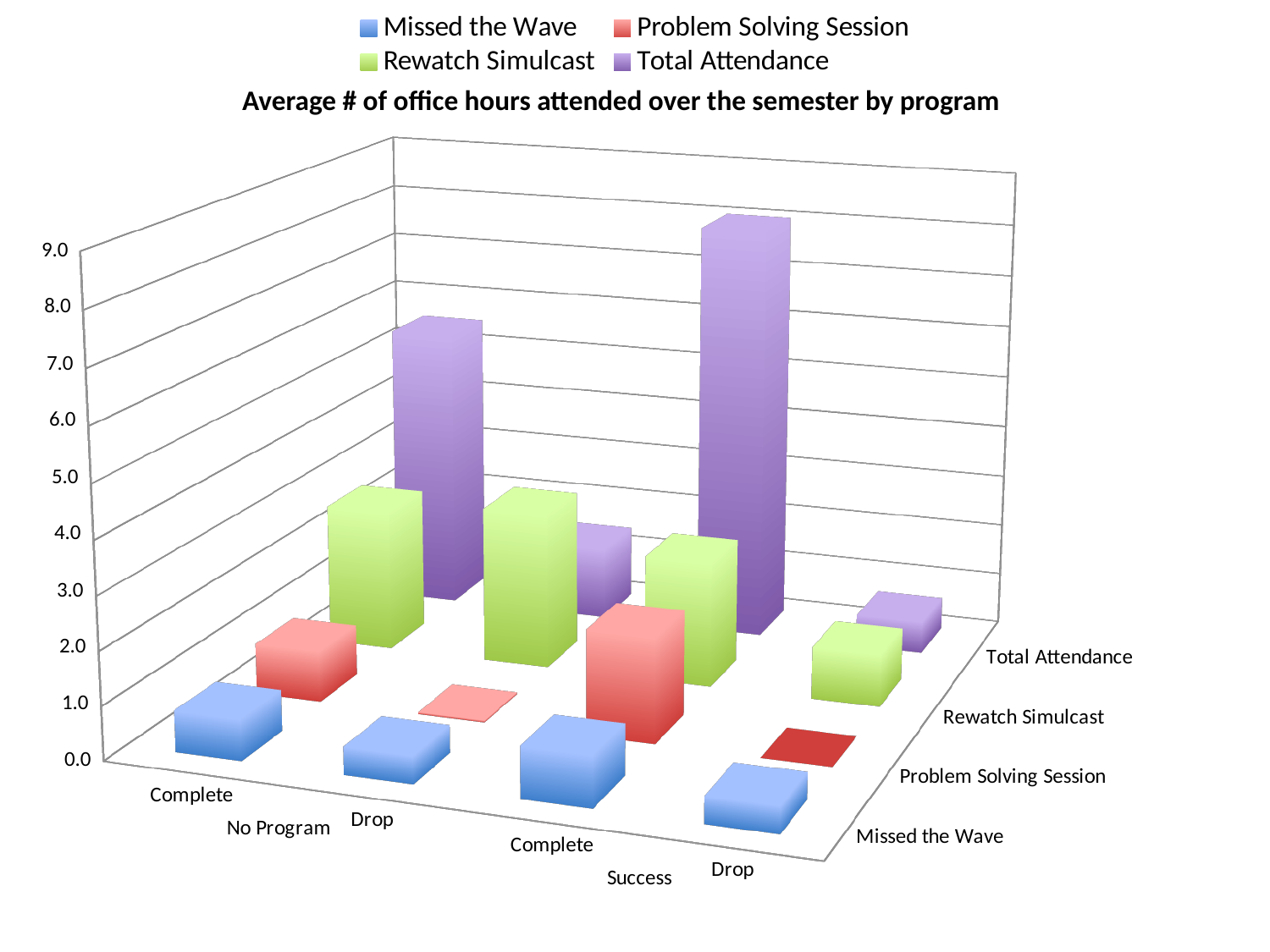
Is the Total Attendance value for Complete under No Program greater or less than 4.0? greater For the Total Attendance series, which category has the lowest value? Drop (Success) Which is larger for Problem Solving Session: Complete under Success or Drop under Success? Complete under Success Which is larger for Total Attendance: Complete under No Program or Complete under Success? Complete under Success Is the Total Attendance value for Complete under Success greater or less than 6.0? greater What kind of chart is shown on the slide? bar chart Is the Problem Solving Session value for Drop under Success greater or less than 1.0? less How many category groups are shown along the x axis? 4 For the Total Attendance series, which category has the highest value? Complete (Success) What is the title of the chart? Average # of office hours attended over the semester by program How many series does the legend list? 4